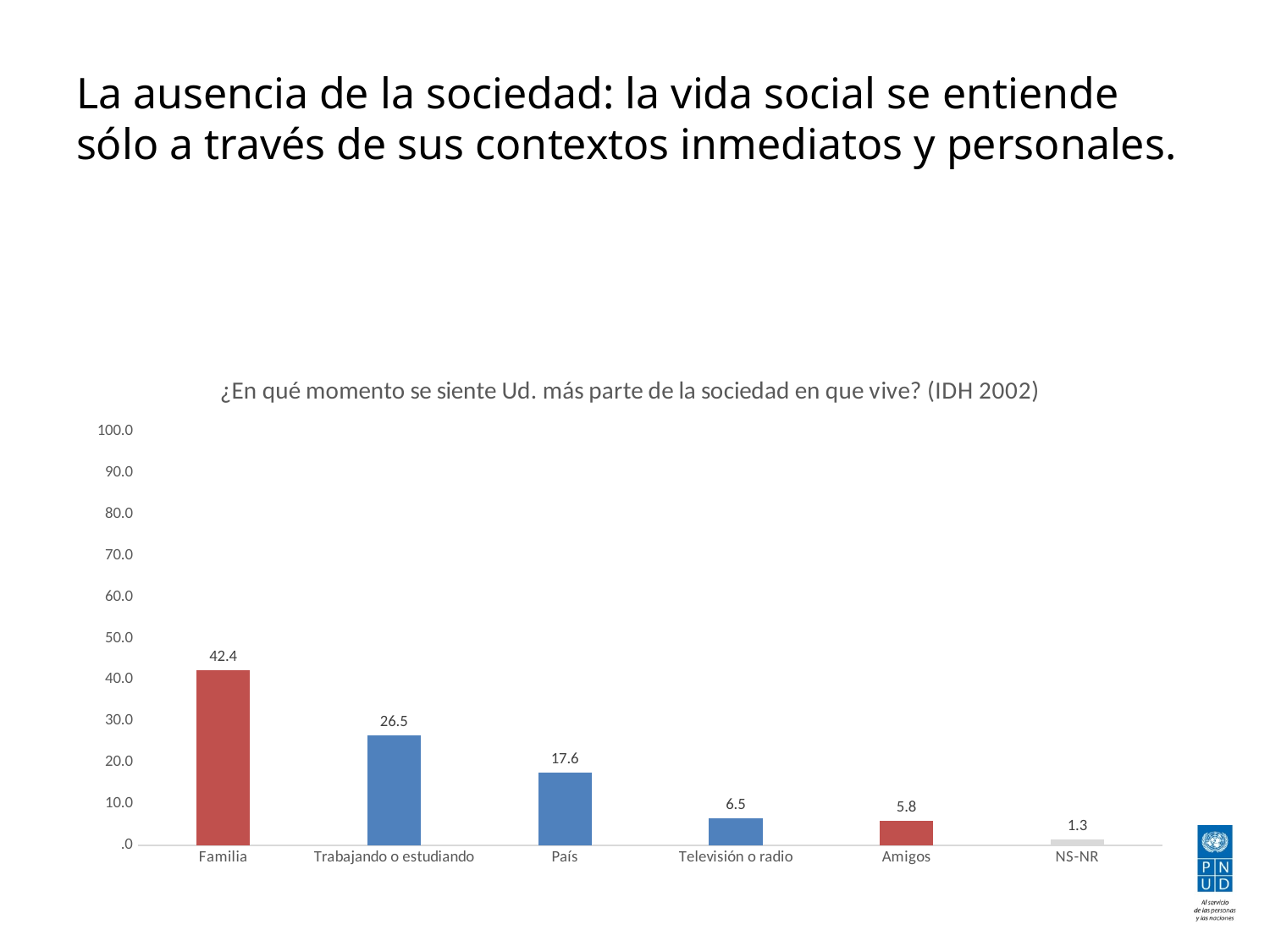
Which category has the highest value? Familia What is the value for Televisión o radio? 6.5 What is the title of the chart? ¿En qué momento se siente Ud. más parte de la sociedad en que vive? (IDH 2002) What is the value for NS-NR? 1.3 Which is larger, the value for Televisión o radio or the value for Amigos? Televisión o radio What kind of chart is shown on the slide? Bar chart What is the difference between the values for Familia and Trabajando o estudiando? 15.9 What is the value for País? 17.6 Which category has the lowest value? NS-NR How many categories are shown on the x axis? 6 What is the value for Familia? 42.4 What is the value for Trabajando o estudiando? 26.5